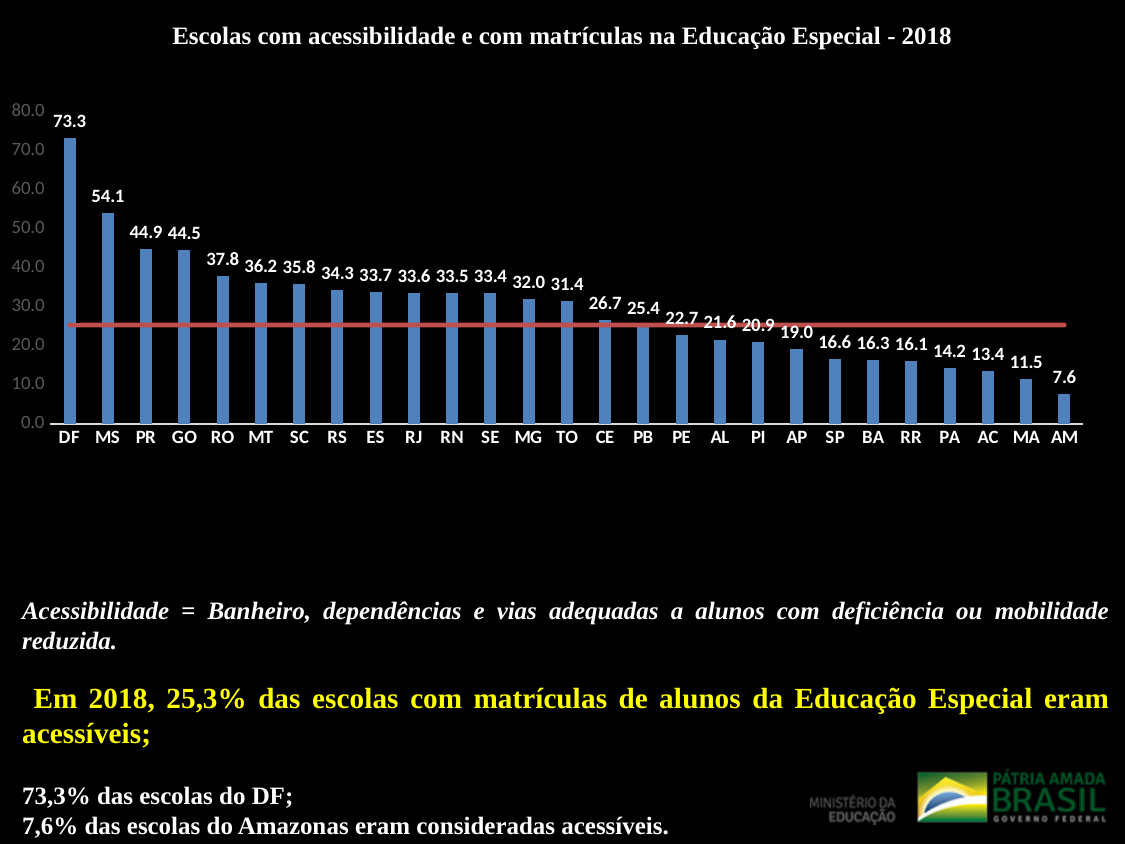
How many states are shown on the x axis? 27 What is the value for DF? 73.3 Which is larger, the value for RO or the value for TO? RO Is the value for PE greater or less than 30.0? less What is the value for MG? 32.0 What is the difference between the values for CE and PB? 1.3 What kind of chart is this? bar chart What is the value for SP? 16.6 What is the difference between the values for DF and MS? 19.2 Which state has the lowest value? AM Which state has the highest value? DF Do the values rise or fall from left to right along the x axis? fall